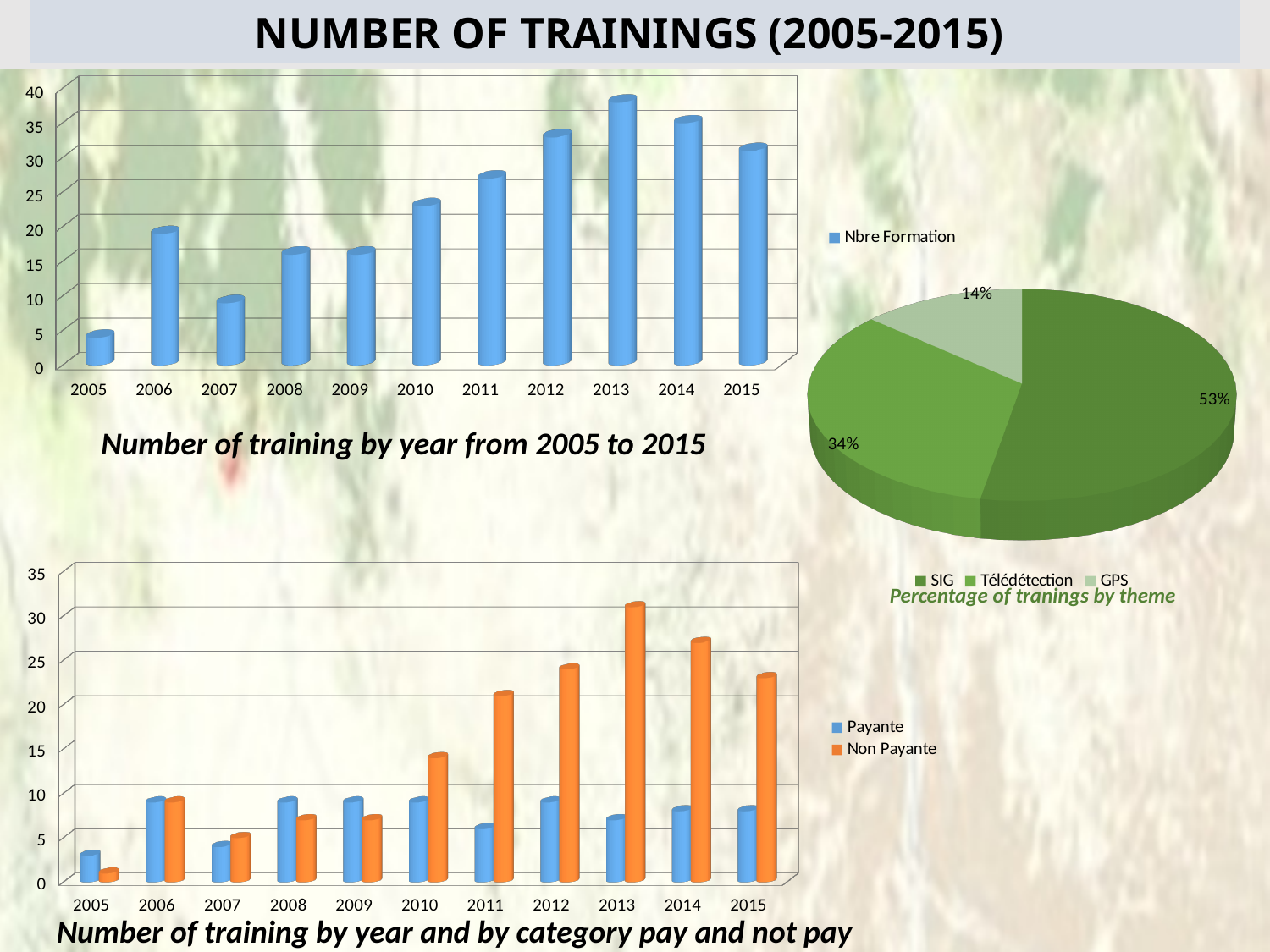
In the chart titled 'Number of training by year from 2005 to 2015', which year has the lowest number of trainings? 2005 In the chart titled 'Number of training by year and by category pay and not pay', is the Non Payante value for 2013 greater or less than 25? greater In the chart titled 'Number of training by year from 2005 to 2015', which year has the highest number of trainings? 2013 In the chart titled 'Number of training by year and by category pay and not pay', how many series does the legend list? 2 In the chart titled 'Number of training by year and by category pay and not pay', which year has the highest Non Payante value? 2013 In the pie chart titled 'Percentage of tranings by theme', what is the difference in percentage points between SIG and Télédétection? 19 In the chart titled 'Number of training by year from 2005 to 2015', what series name does the legend show? Nbre Formation In the pie chart titled 'Percentage of tranings by theme', what share does SIG have? 53% In the chart titled 'Number of training by year from 2005 to 2015', is the value for 2013 greater or less than 35? greater In the pie chart titled 'Percentage of tranings by theme', what share does GPS have? 14% In the chart titled 'Number of training by year from 2005 to 2015', how many years are shown on the x axis? 11